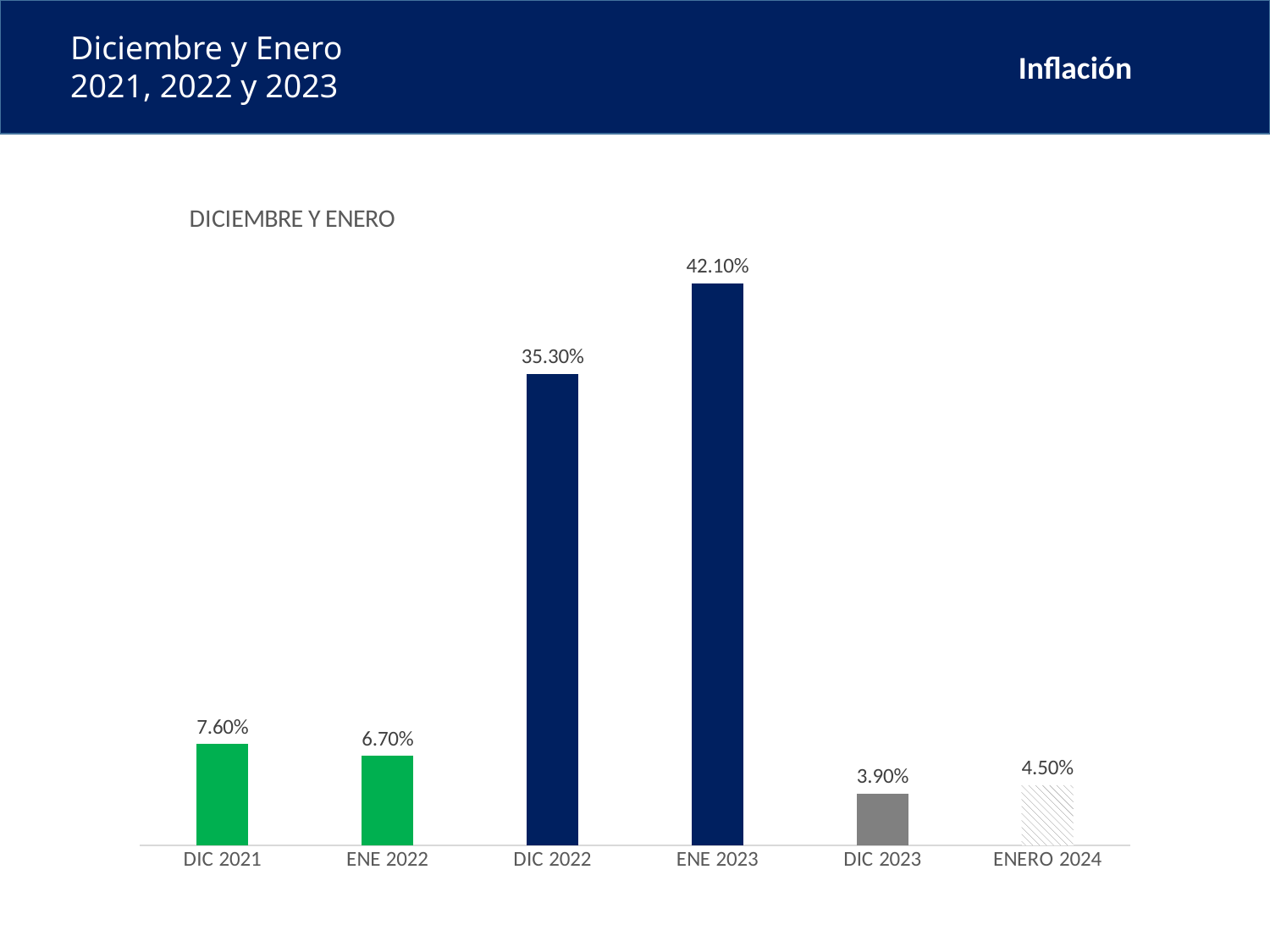
What is the value for ENE 2023? 42.10% What is the title of the chart? DICIEMBRE Y ENERO What is the difference between the values for ENE 2023 and DIC 2022? 6.80% Which category has the highest value? ENE 2023 How many categories are shown on the x axis? 6 Which category has the lowest value? DIC 2023 What colour are the bars for DIC 2021 and ENE 2022? Green What is the value for DIC 2021? 7.60% What kind of chart is shown on the slide? Bar chart Which is larger, the value for ENERO 2024 or the value for DIC 2023? ENERO 2024 What is the difference between the values for DIC 2021 and ENE 2022? 0.90% What is the value for ENERO 2024? 4.50%